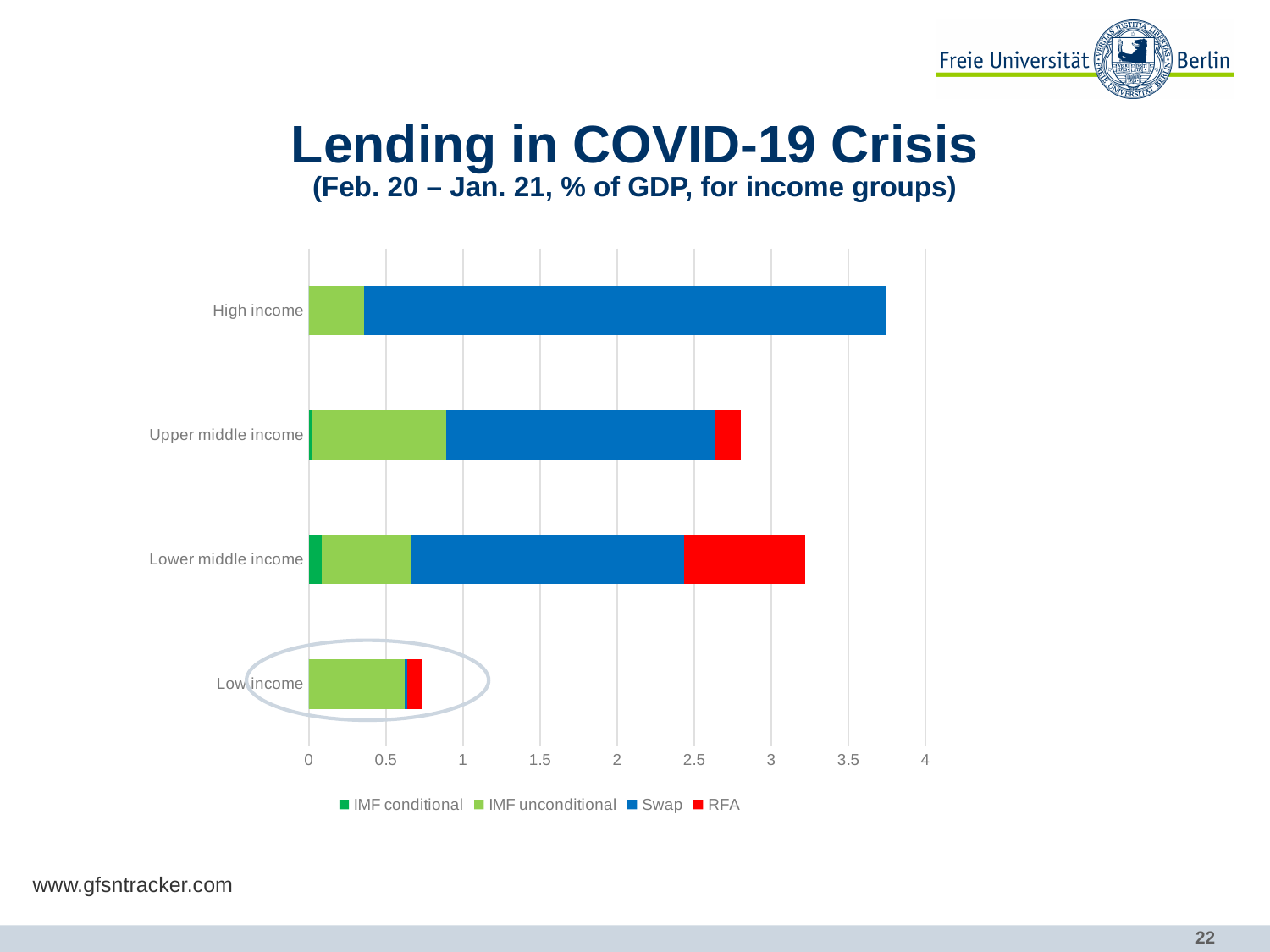
Which colour represents RFA in the legend? Red Which income group is circled on the chart? Low income Is the total value for Low income greater or less than 1? less How many income groups are shown on the chart? 4 Is the total value for High income greater or less than 3.5? greater Is the total value for Upper middle income greater or less than 3? less Which has a larger total bar, Lower middle income or Upper middle income? Lower middle income How many series does the legend list? 4 What kind of chart is shown on the slide? Stacked bar chart Which income group has the smallest total lending as a share of GDP? Low income Which income group has the largest total lending as a share of GDP? High income